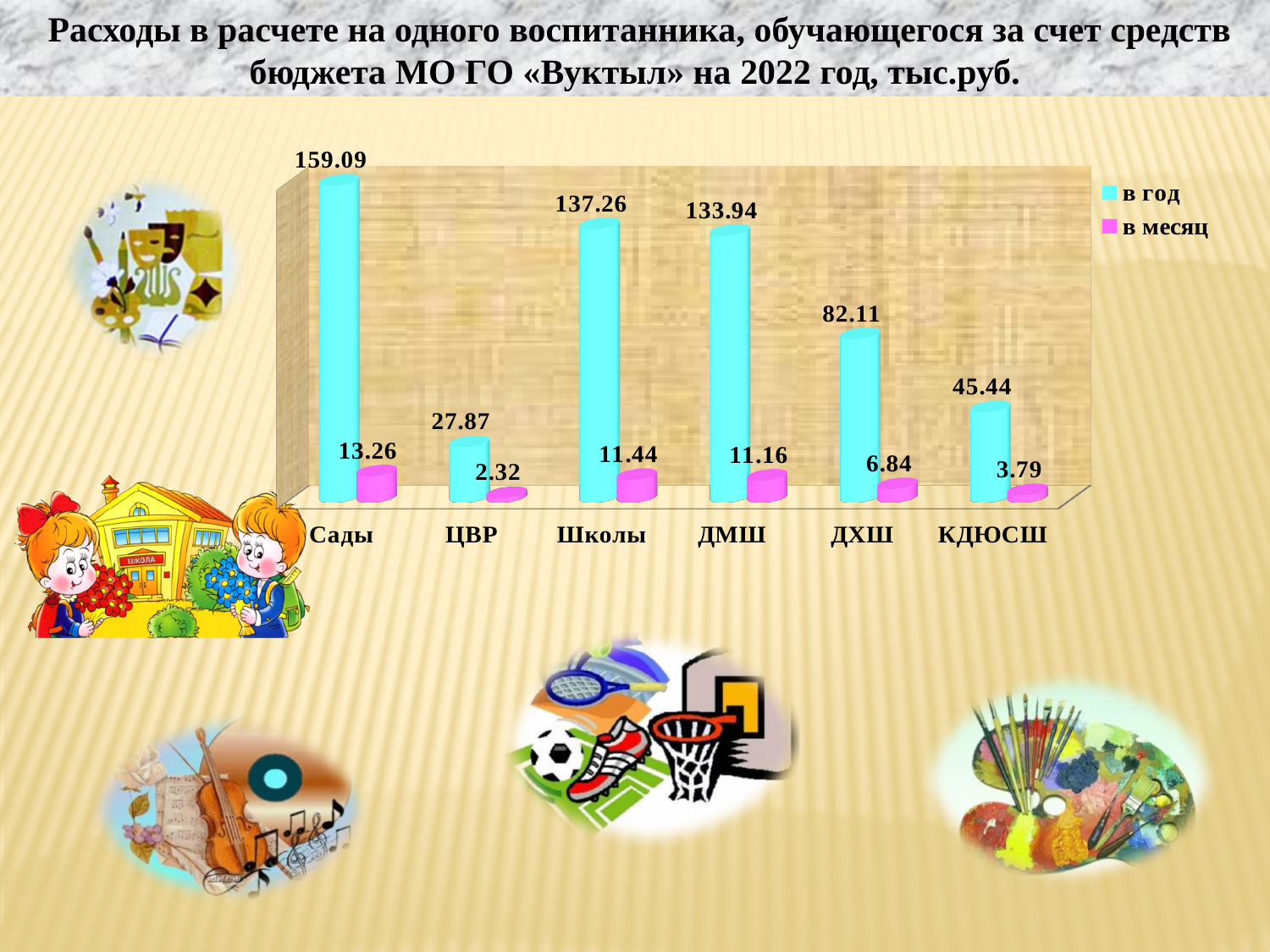
Which category has the highest value in the 'в год' series? Сады How many categories are shown on the x axis? 6 What is the value for Сады in the 'в год' series? 159.09 What is the value for КДЮСШ in the 'в месяц' series? 3.79 What kind of chart is shown on the slide? Bar chart How many series does the legend list? 2 What is the difference between the 'в год' values for Школы and ДМШ? 3.32 What is the value for ЦВР in the 'в месяц' series? 2.32 What is the value for ДХШ in the 'в год' series? 82.11 Which is larger in the 'в год' series: ДХШ or КДЮСШ? ДХШ Which category has the lowest value in the 'в месяц' series? ЦВР Which colour represents the 'в месяц' series in the legend? Magenta (pink)